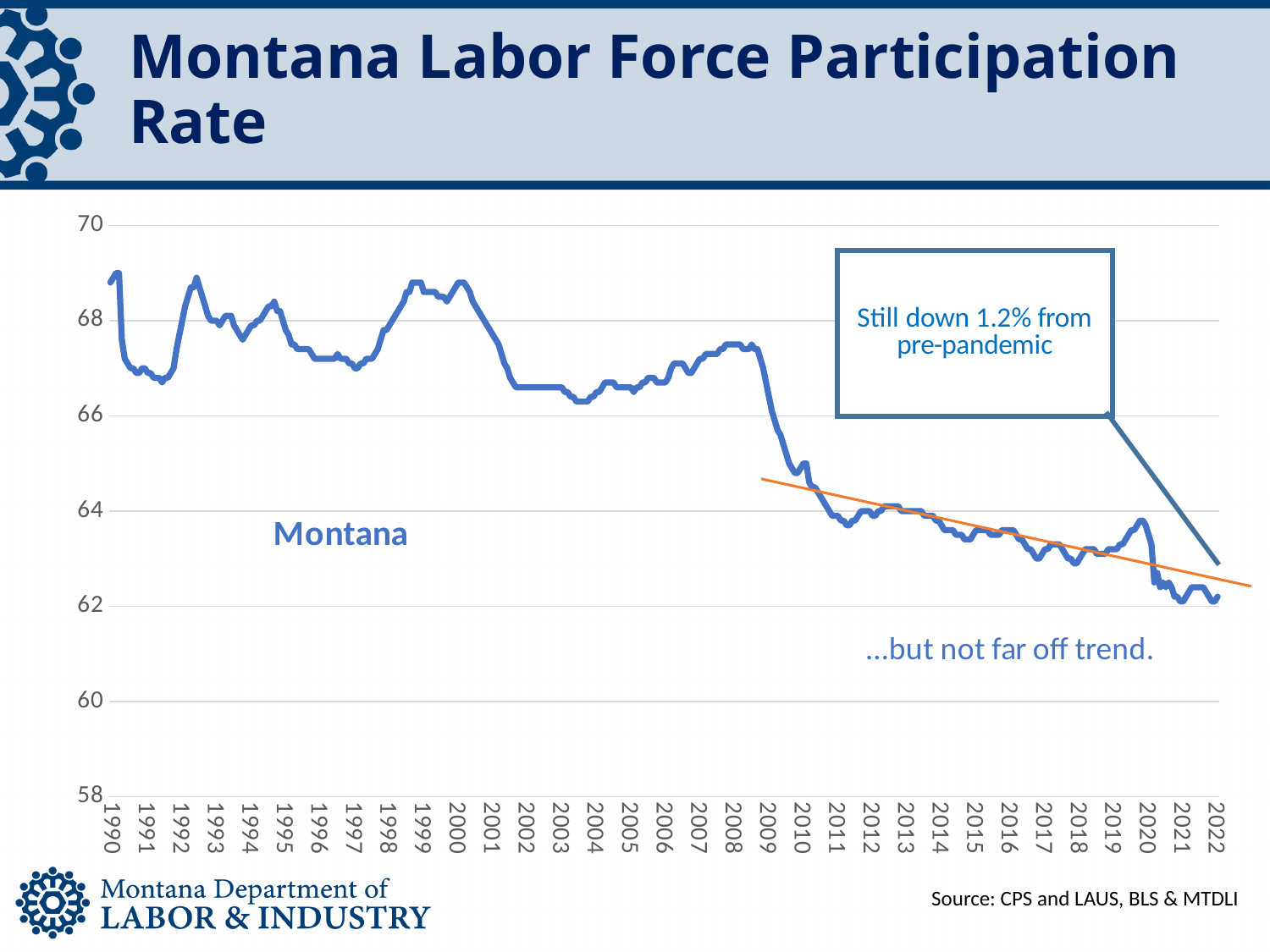
Is the value for 2021 greater or less than 64? less Overall, does the Montana labor force participation rate rise or fall from 1990 to 2022? fall Is the value for 1990 greater or less than 68? greater Is the value for 2003 greater or less than 68? less How many year labels are shown on the x axis? 33 Which year has a higher labor force participation rate, 1999 or 2021? 1999 What is the title of the chart on the slide? Montana Labor Force Participation Rate In which year does the line reach its lowest value? 2021 What kind of chart is shown on the slide? line chart According to the annotation box, how far is the rate still down from pre-pandemic? 1.2%